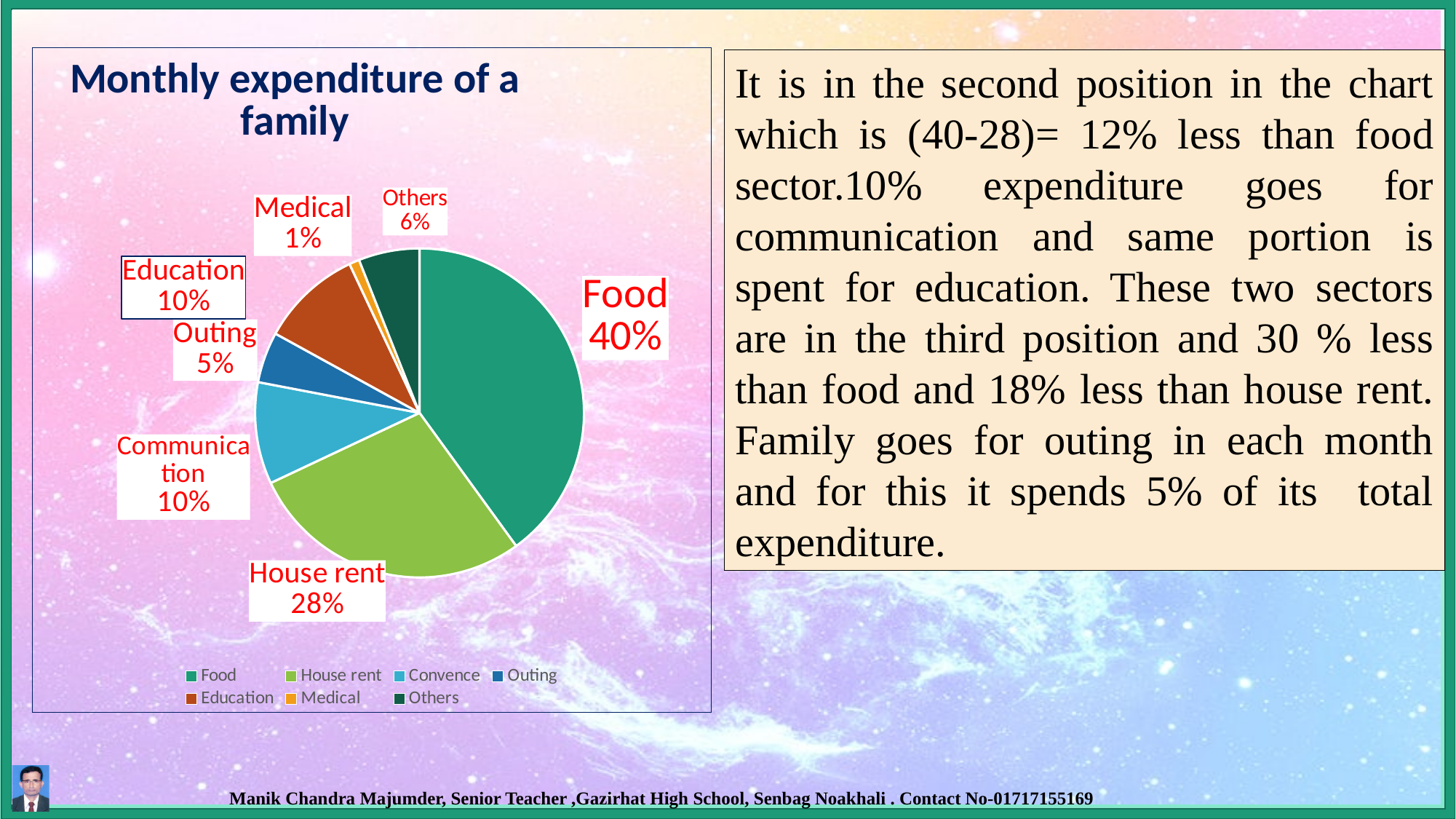
What type of chart is shown on the slide? Pie chart How many entries does the legend list? 7 What percentage of monthly expenditure goes to Medical? 1% Which category has the largest share of the pie? Food What percentage of monthly expenditure goes to Food? 40% What percentage of monthly expenditure goes to House rent? 28% What percentage of monthly expenditure goes to Others? 6% Which category has the smallest share of the pie? Medical What is the title of the chart? Monthly expenditure of a family What is the difference between the Food share and the House rent share? 12% How many slices does the pie chart have? 7 Which is larger, the share for Outing or the share for Others? Others